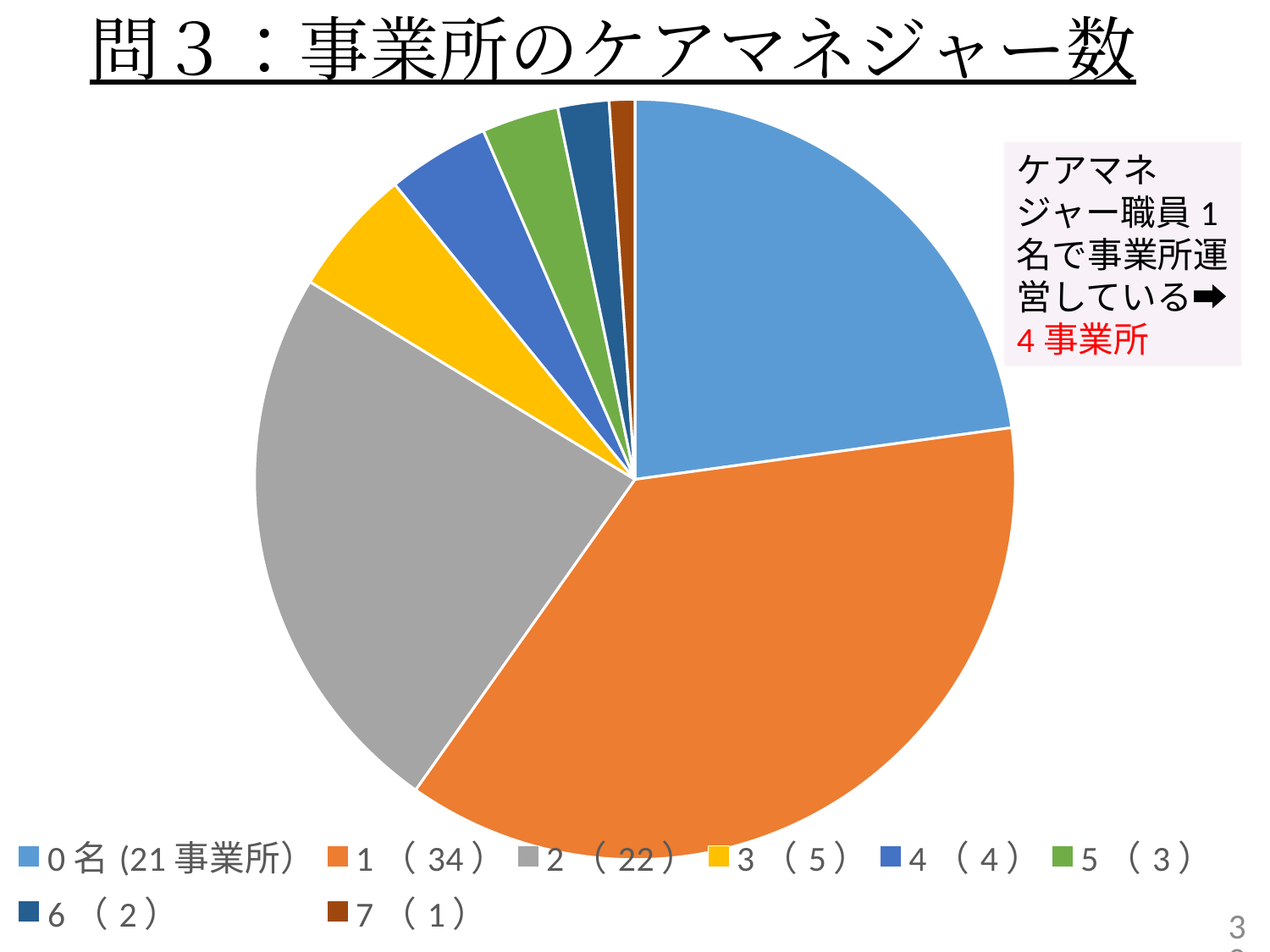
What is the total number of 事業所 across all slices of the pie? 92 What kind of chart is shown on the slide? pie chart How many categories (slices) does the pie chart have? 8 How many 事業所 have 1 care manager according to the legend? 34 What colour is the slice for 1（34）? orange Which is larger: the number of 事業所 with 2 care managers or with 3 care managers? 2 (22) What is the title of the chart? 問３：事業所のケアマネジャー数 What is the difference between the number of 事業所 with 1 care manager and those with 0名? 13 How many 事業所 have 2 care managers? 22 Which category has the largest slice of the pie? 1（34） Which category has the smallest slice of the pie? 7（1） How many 事業所 have 0名 care managers? 21